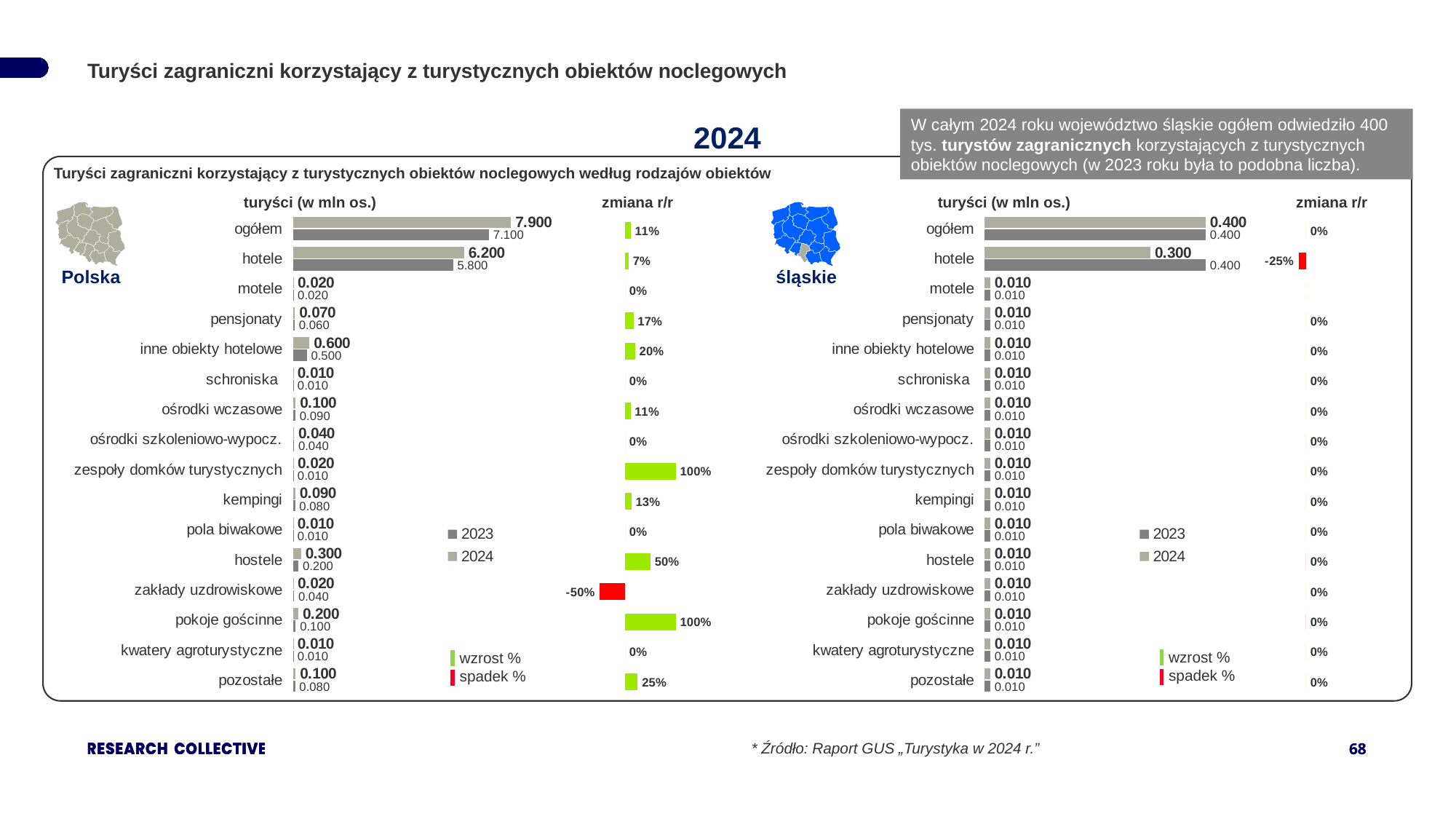
What type of chart is used to show turyści (w mln os.) for Polska? bar chart In the Polska chart, what is the zmiana r/r for zakłady uzdrowiskowe? -50% In the Polska chart, which categories show a zmiana r/r of 100%? zespoły domków turystycznych and pokoje gościnne How many accommodation categories (rows) are listed in the Polska chart? 16 In the śląskie chart, what is the 2023 value for hotele? 0.400 How many series does the legend of the Polska turyści chart list? 2 In the Polska chart, what is the difference between the 2024 and 2023 values for ogółem? 0.800 In the śląskie chart, what is the zmiana r/r for hotele? -25% In the Polska chart, what is the 2023 value for ogółem? 7.100 In the Polska chart, which is larger: the 2024 value for hostele or the 2024 value for pokoje gościnne? hostele In the Polska chart, what is the 2024 value for hotele (turyści w mln os.)? 6.200 In the Polska chart, which category other than ogółem has the highest 2024 value? hotele